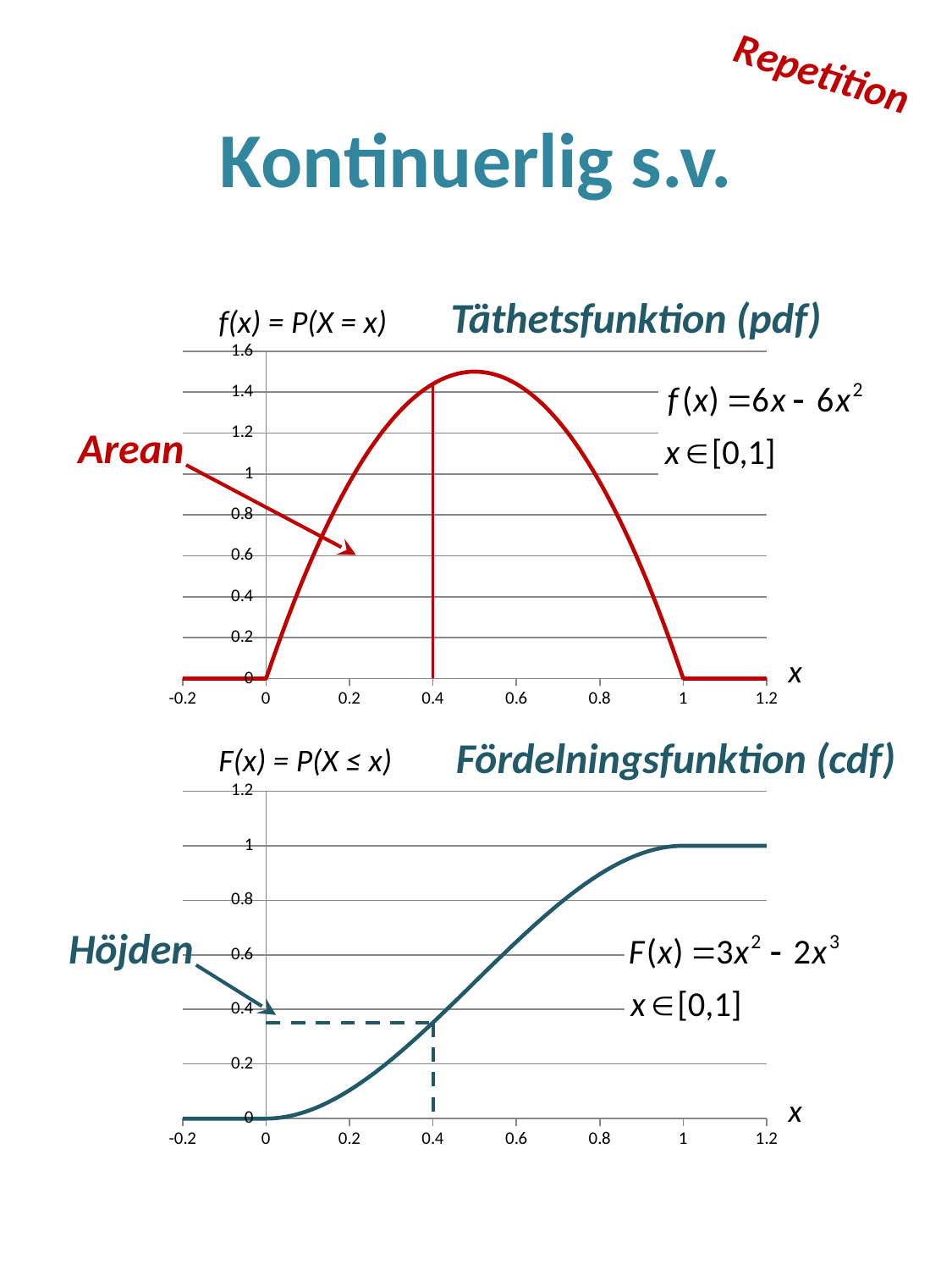
What formula is given for f(x) next to the top chart 'Täthetsfunktion (pdf)'? f(x) = 6x - 6x² In the top chart 'Täthetsfunktion (pdf)', what is the value of f(x) at x = 1? 0 In the top chart 'Täthetsfunktion (pdf)', what is the value of f(x) at x = 0? 0 How many tick labels are shown on the x axis of the bottom chart 'Fördelningsfunktion (cdf)'? 8 What kind of chart is the top chart titled 'Täthetsfunktion (pdf)'? line chart What kind of chart is the bottom chart titled 'Fördelningsfunktion (cdf)'? line chart In the bottom chart 'Fördelningsfunktion (cdf)', what is the value of F(x) at x = 1? 1 In the bottom chart 'Fördelningsfunktion (cdf)', does F(x) rise or fall as x increases from 0 to 1? rise In the top chart 'Täthetsfunktion (pdf)', what is the highest value shown on the y axis? 1.6 In the top chart 'Täthetsfunktion (pdf)', is the peak value of the curve greater or less than 1.2? greater In the top chart 'Täthetsfunktion (pdf)', is the value of f(x) at x = 0.4 greater or less than 1.2? greater In the bottom chart 'Fördelningsfunktion (cdf)', is the value of F(x) at x = 0.4 greater or less than 0.4? less